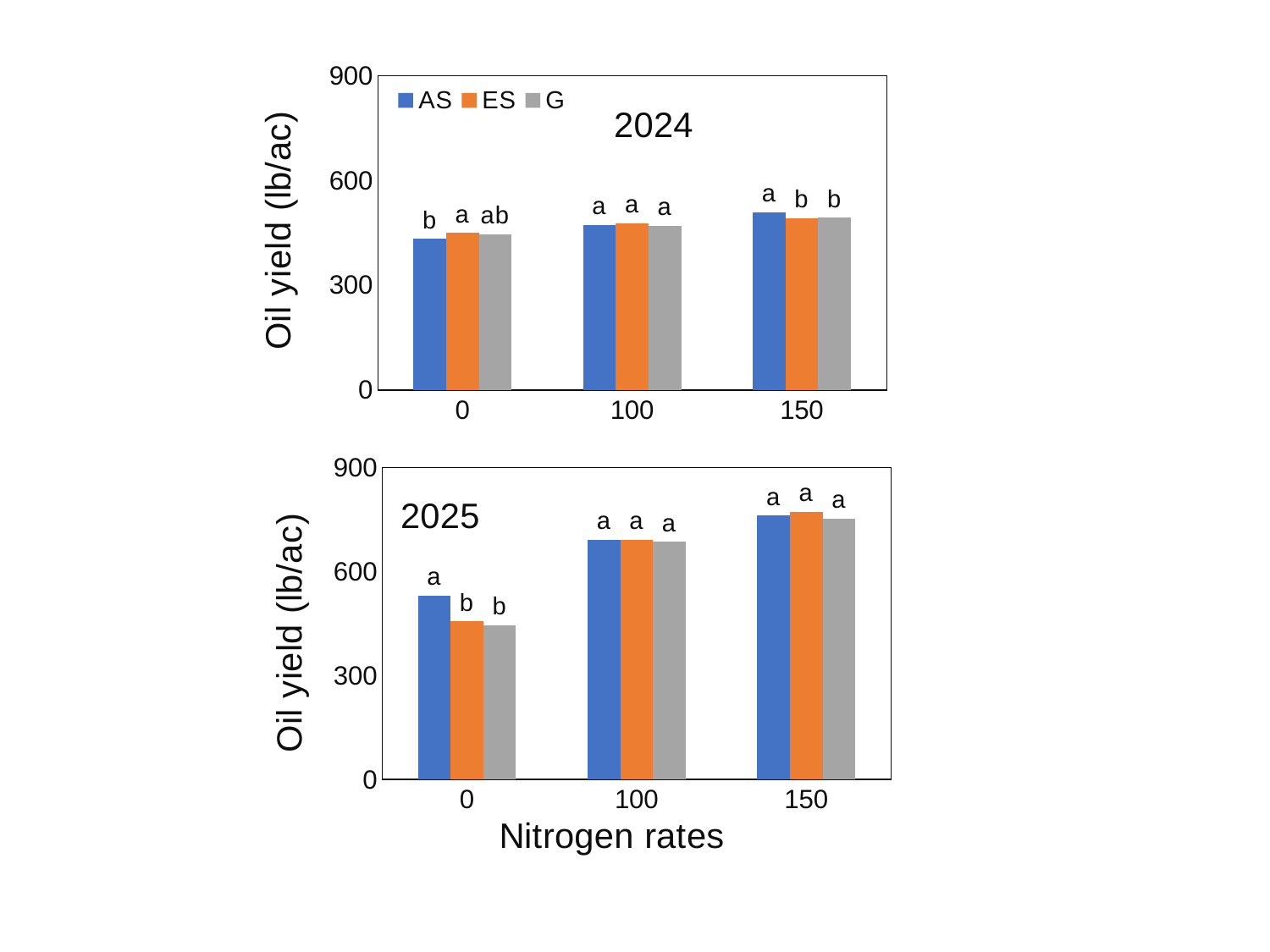
On the 2025 chart, do the AS values rise or fall as the nitrogen rate increases from 0 to 150? rise What is the y-axis label on the 2024 chart? Oil yield (lb/ac) On the 2025 chart, is the value for ES at nitrogen rate 100 greater or less than 600? greater On the 2025 chart, is the value for AS at nitrogen rate 0 greater or less than 600? less On the 2024 chart, is the value for AS at nitrogen rate 0 greater or less than 300? greater On the 2025 chart, at nitrogen rate 0, which is larger, AS or ES? AS How many nitrogen rate categories are shown on the x axis of the 2025 chart? 3 How many series does the legend on the 2024 chart list? 3 On the 2025 chart, at which nitrogen rate is the AS bar highest? 150 What kind of chart is the top chart labelled 2024? bar chart On the 2025 chart, at which nitrogen rate is the G bar lowest? 0